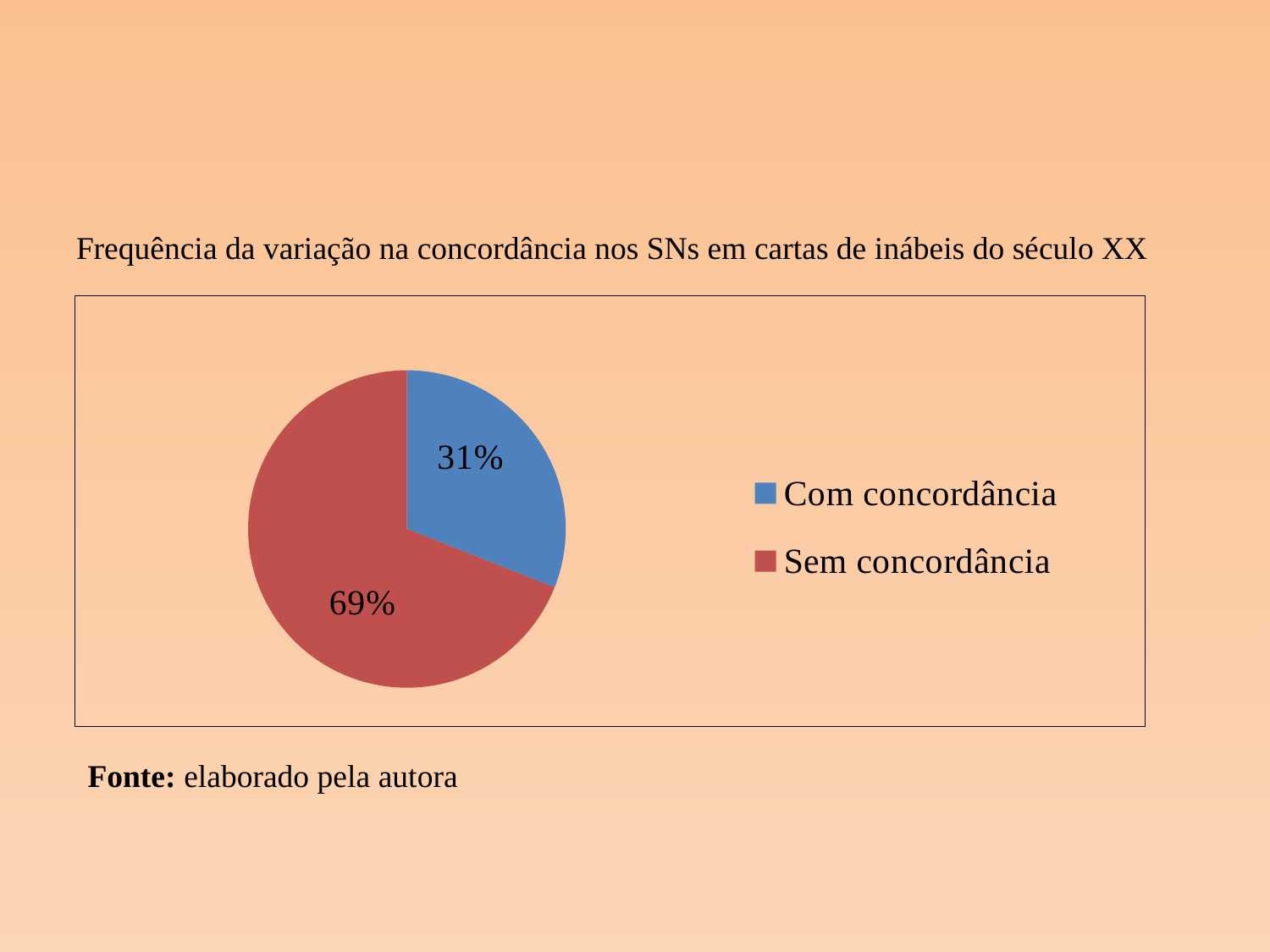
What is the title shown above the chart? Frequência da variação na concordância nos SNs em cartas de inábeis do século XX Which category has the smallest slice of the pie? Com concordância Which is larger, the slice for "Com concordância" or the slice for "Sem concordância"? Sem concordância What share of the pie does "Com concordância" represent? 31% What share of the pie does "Sem concordância" represent? 69% Which category has the largest slice of the pie? Sem concordância What is the difference in percentage points between "Sem concordância" and "Com concordância"? 38 How many slices does the pie chart have? 2 How many entries does the legend list? 2 What colour is the slice for "Sem concordância"? red What kind of chart is shown on the slide? pie chart